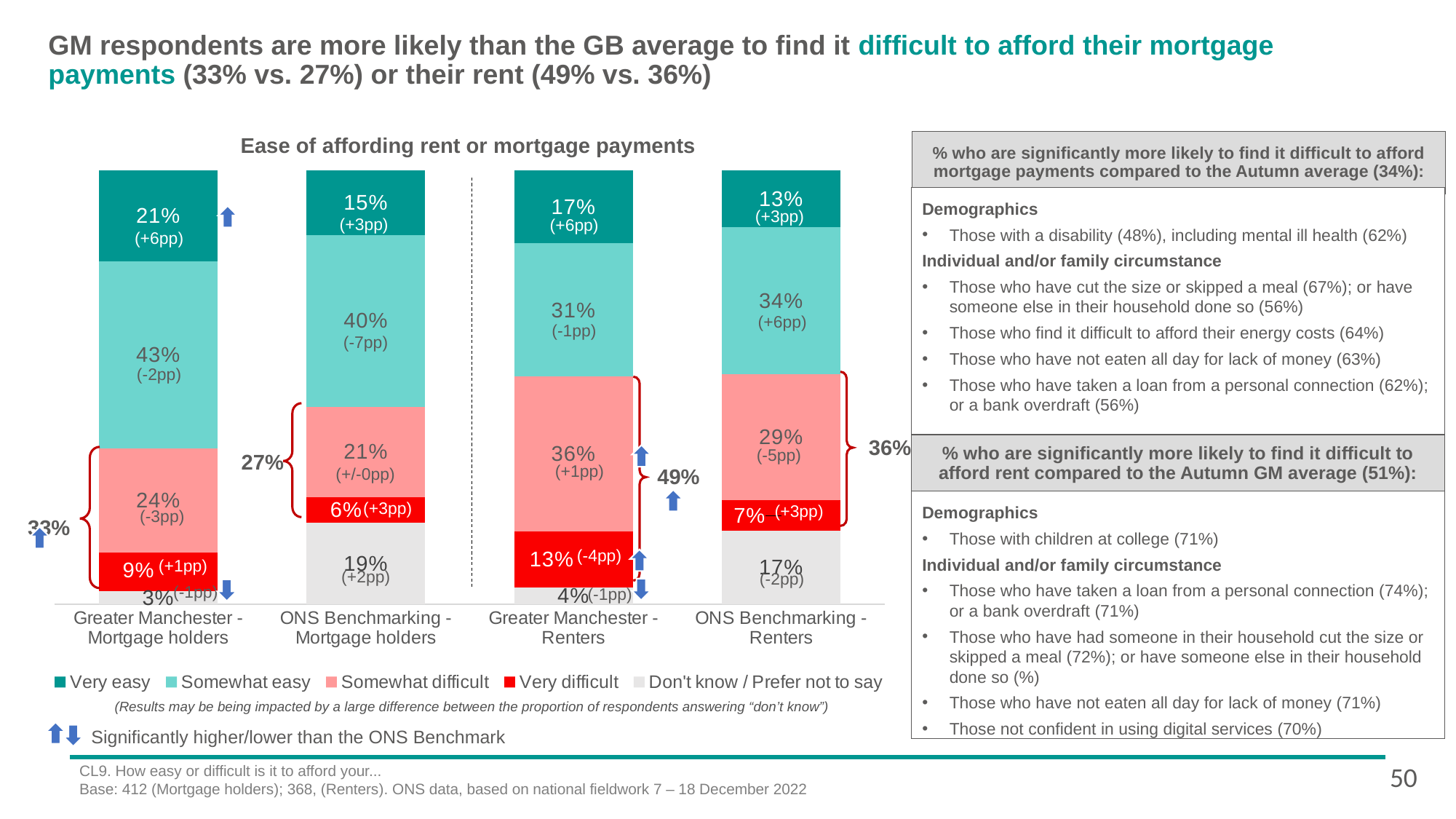
What is the 'Don't know / Prefer not to say' value for ONS Benchmarking - Mortgage holders? 19% What is the combined 'Somewhat difficult' and 'Very difficult' share for Greater Manchester - Renters, as labelled by the brace? 49% How many series does the legend list? 5 What is the 'Very difficult' value for ONS Benchmarking - Renters? 7% Which category has the lowest 'Very easy' value? ONS Benchmarking - Renters Which is larger: the 'Somewhat easy' value for ONS Benchmarking - Mortgage holders or for Greater Manchester - Renters? ONS Benchmarking - Mortgage holders What is the 'Very easy' value for Greater Manchester - Mortgage holders? 21% What type of chart is shown on the slide? Stacked bar chart Which category has the highest 'Somewhat easy' value? Greater Manchester - Mortgage holders What is the difference between the 'Very difficult' values for Greater Manchester - Renters and ONS Benchmarking - Renters? 6% What is the 'Somewhat difficult' value for Greater Manchester - Renters? 36% How many categories are shown along the x axis? 4